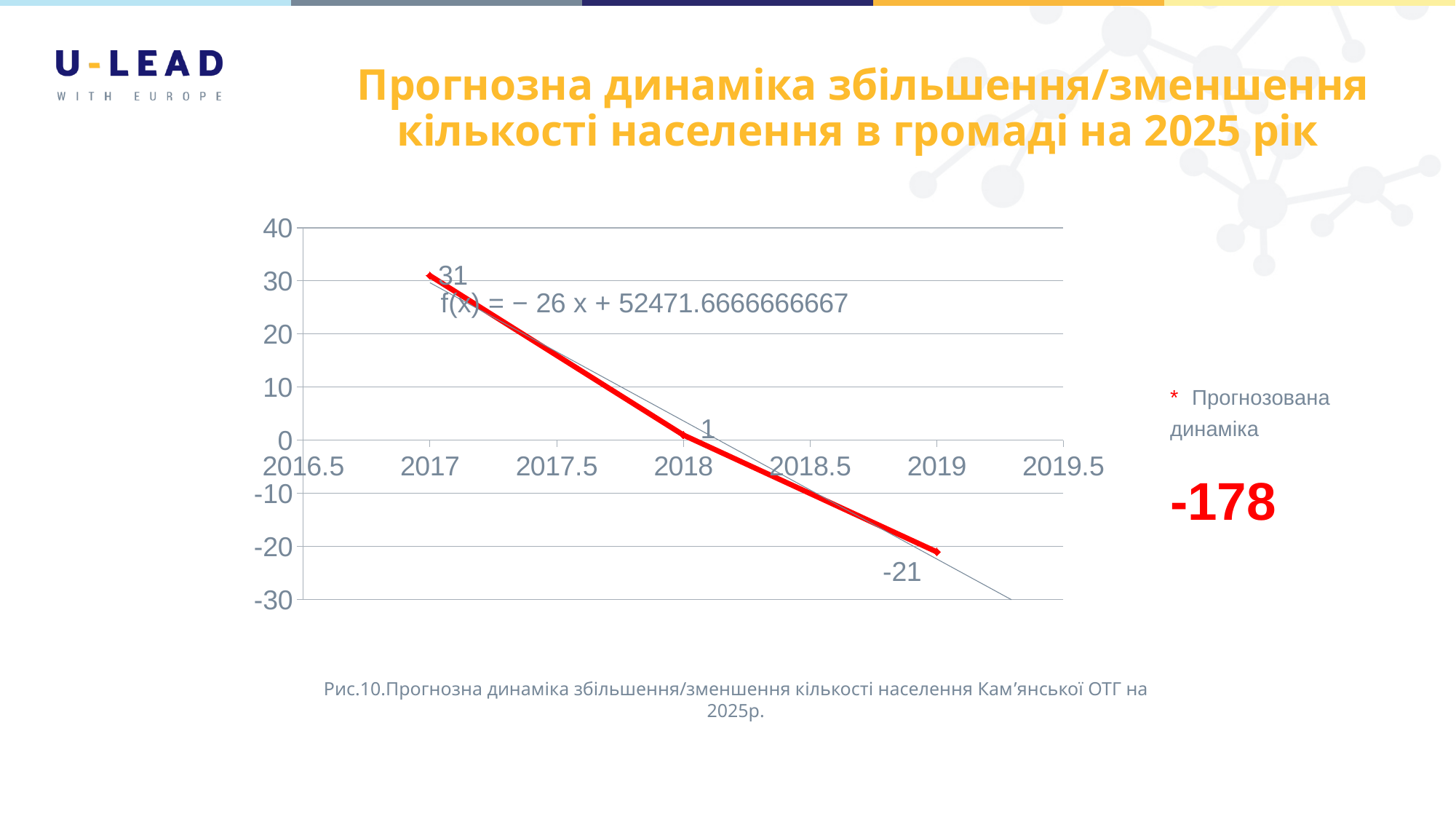
What is the value plotted for 2017? 31 What is the trendline equation shown on the chart? f(x) = − 26 x + 52471.6666666667 Which year has the highest plotted value? 2017 Which is larger, the value for 2017 or the value for 2019? 2017 What is the value plotted for 2018? 1 What is the difference between the values for 2018 and 2019? 22 Which year has the lowest plotted value? 2019 What is the difference between the values for 2017 and 2018? 30 How many data points are plotted on the chart? 3 What kind of chart is shown on the slide? line chart Do the plotted values rise or fall from 2017 to 2019? fall What is the value plotted for 2019? -21